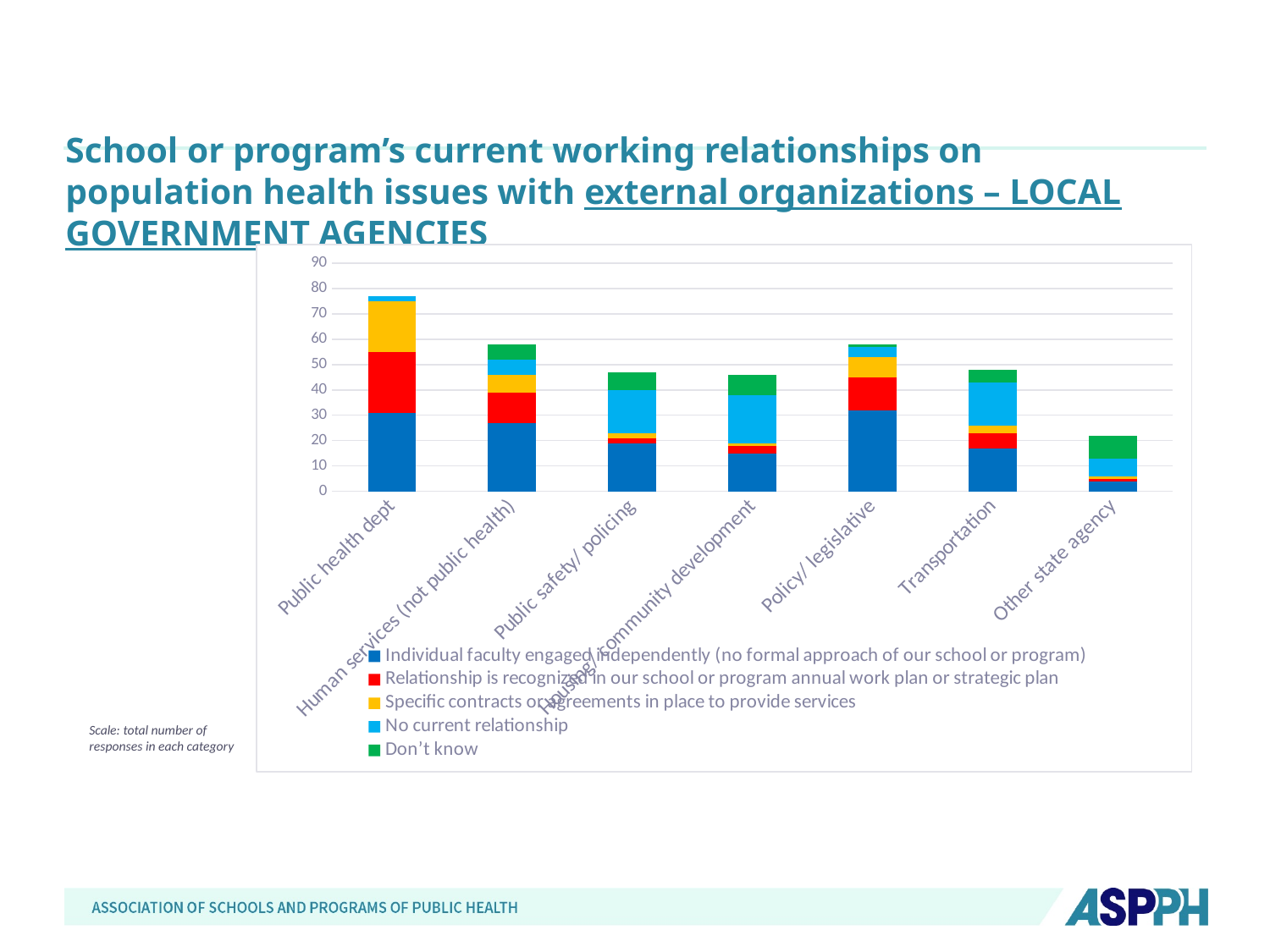
Is the total bar height for Other state agency greater or less than 30? less What kind of chart is shown on the slide? Stacked bar chart Is the total bar height for Housing/ community development greater or less than 50? less Which category has the tallest stacked bar overall? Public health dept How many series does the chart's legend list? 5 How many categories are shown on the x axis of the chart? 7 Which colour represents the 'Don't know' series in the legend? Green Is the total bar height for Policy/ legislative greater or less than 50? greater Which has a taller total bar, Public health dept or Transportation? Public health dept According to the note on the slide, what does the scale of the chart represent? Total number of responses in each category Which category has the shortest stacked bar overall? Other state agency